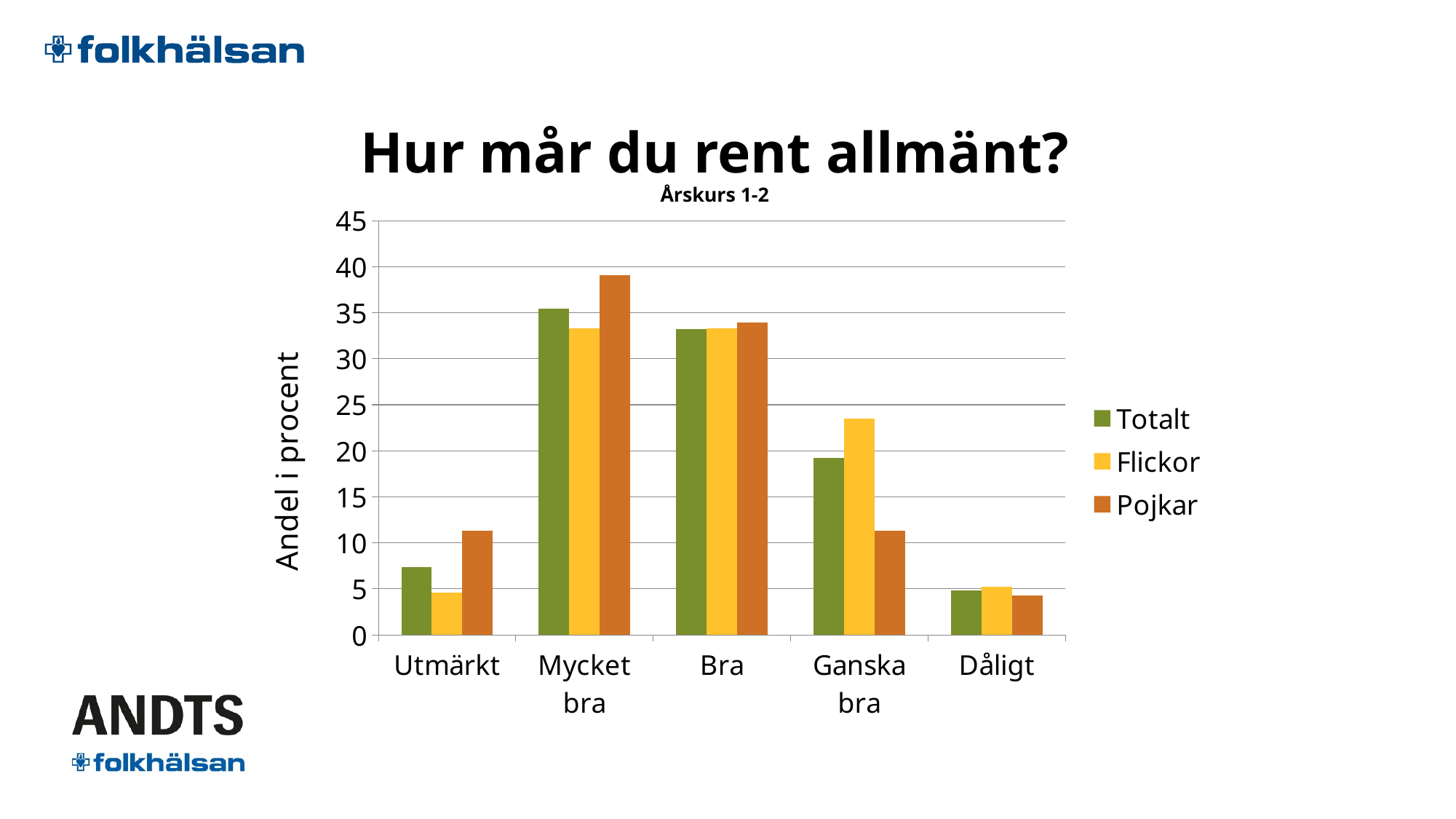
How many series does the legend list? 3 For the Flickor series, which category has the lowest value? Utmärkt For the Pojkar series, which category has the highest value? Mycket bra What kind of chart is shown on the slide? bar chart What is the label on the vertical axis? Andel i procent For Utmärkt, which is larger: the Pojkar value or the Totalt value? Pojkar How many categories are shown on the x axis? 5 Is the Flickor value for Ganska bra greater or less than 20? greater What is the subtitle shown below the chart title? Årskurs 1-2 Is the Totalt value for Utmärkt greater or less than 10? less Is the Pojkar value for Mycket bra greater or less than 35? greater For Ganska bra, which is larger: the Flickor value or the Pojkar value? Flickor